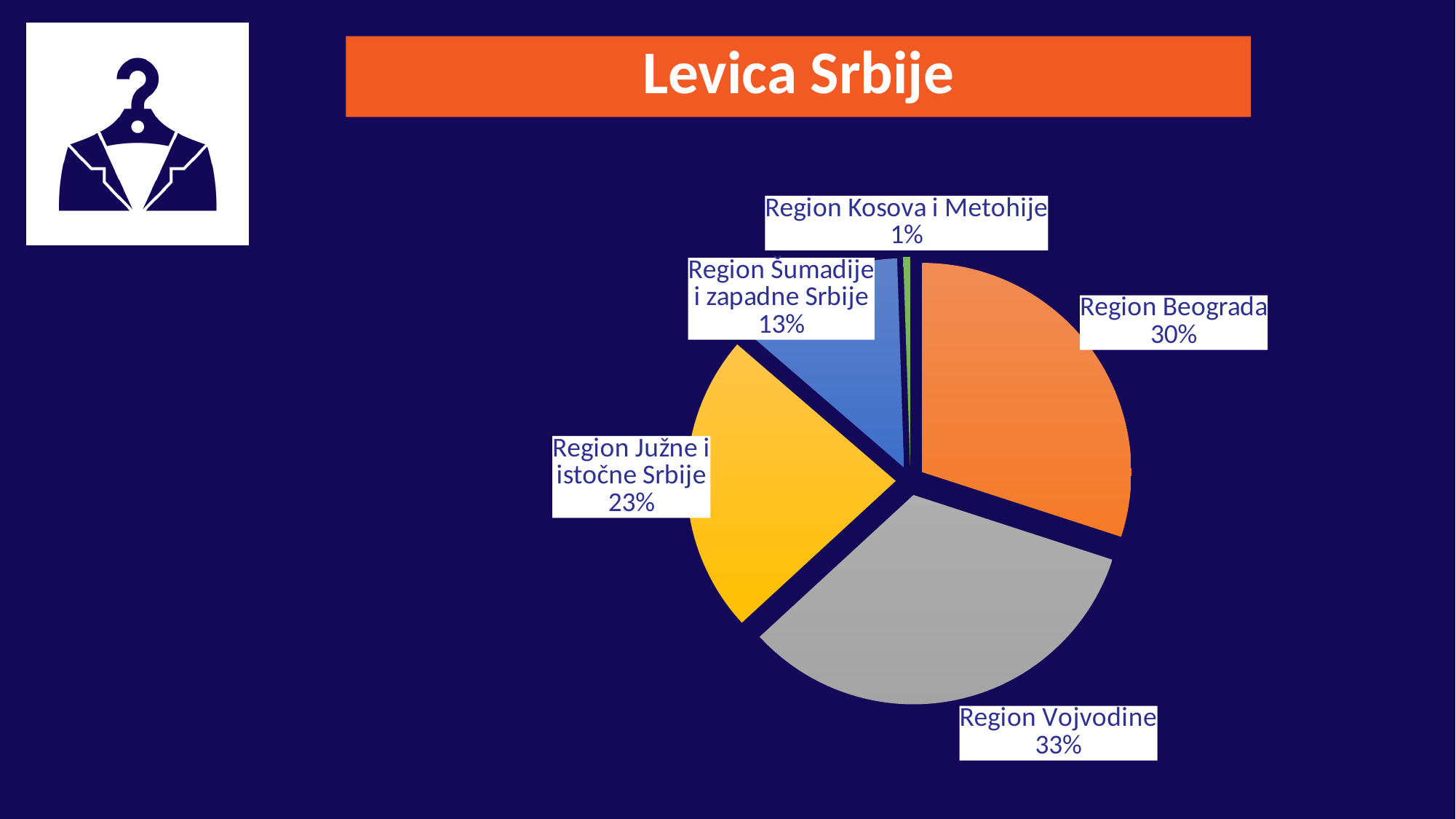
What is the title shown above the chart? Levica Srbije What is the value shown for Region Šumadije i zapadne Srbije? 13% What share of the pie does Region Vojvodine have? 33% What is the value shown for Region Kosova i Metohije? 1% What is the value shown for Region Južne i istočne Srbije? 23% What is the value shown for Region Beograda? 30% Which region has the smallest slice of the pie? Region Kosova i Metohije Which is larger, the share for Region Južne i istočne Srbije or the share for Region Šumadije i zapadne Srbije? Region Južne i istočne Srbije Which region has the largest slice of the pie? Region Vojvodine How many slices does the pie chart have? 5 What is the difference between the shares of Region Vojvodine and Region Beograda? 3% What kind of chart is shown on the slide? pie chart